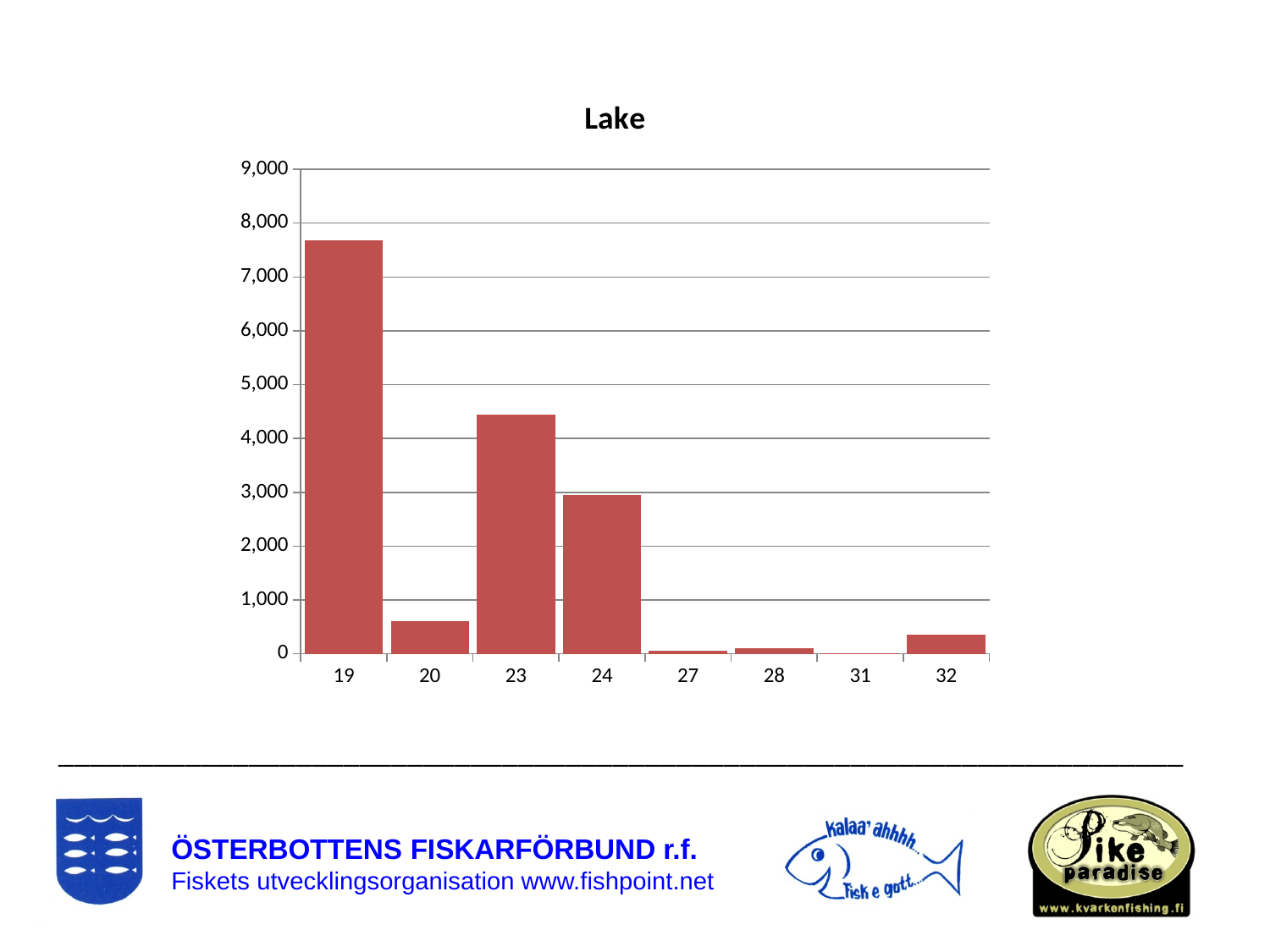
Is the value for category 24 greater or less than 2,000? greater Is the value for category 19 greater or less than 7,000? greater What is the title of the chart? Lake Is the value for category 32 greater or less than 1,000? less Which has a larger value, category 20 or category 32? 20 Which category has the highest value in the chart? 19 Which has a larger value, category 19 or category 23? 19 Which has a larger value, category 23 or category 24? 23 What kind of chart is shown on the slide? bar chart How many categories are shown on the x axis of the chart? 8